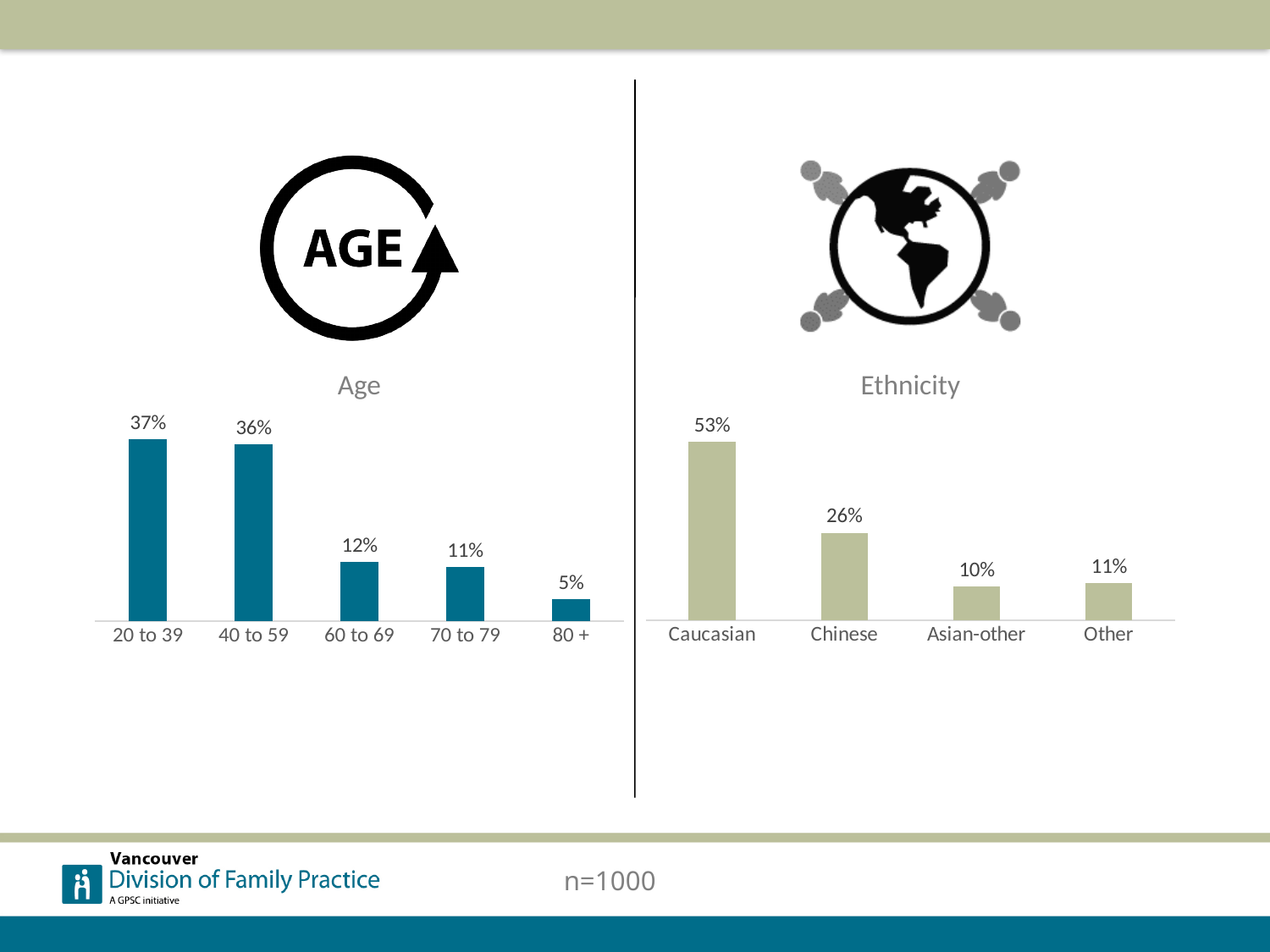
What kind of chart is the Ethnicity chart? bar chart In the Age chart, how many age categories are shown? 5 In the Age chart, which age group has the lowest value? 80 + In the Ethnicity chart, what is the difference between the values for Caucasian and Chinese? 27% In the Age chart, which age group has the highest value? 20 to 39 In the Age chart, what is the value for the 80 + category? 5% In the Age chart, what is the value for the 20 to 39 category? 37% In the Ethnicity chart, how many categories are shown? 4 In the Age chart, do the values rise or fall from left to right along the x axis? fall In the Ethnicity chart, what is the value for Chinese? 26% In the Age chart, what is the difference between the values for 40 to 59 and 60 to 69? 24% In the Ethnicity chart, which category has the highest value? Caucasian